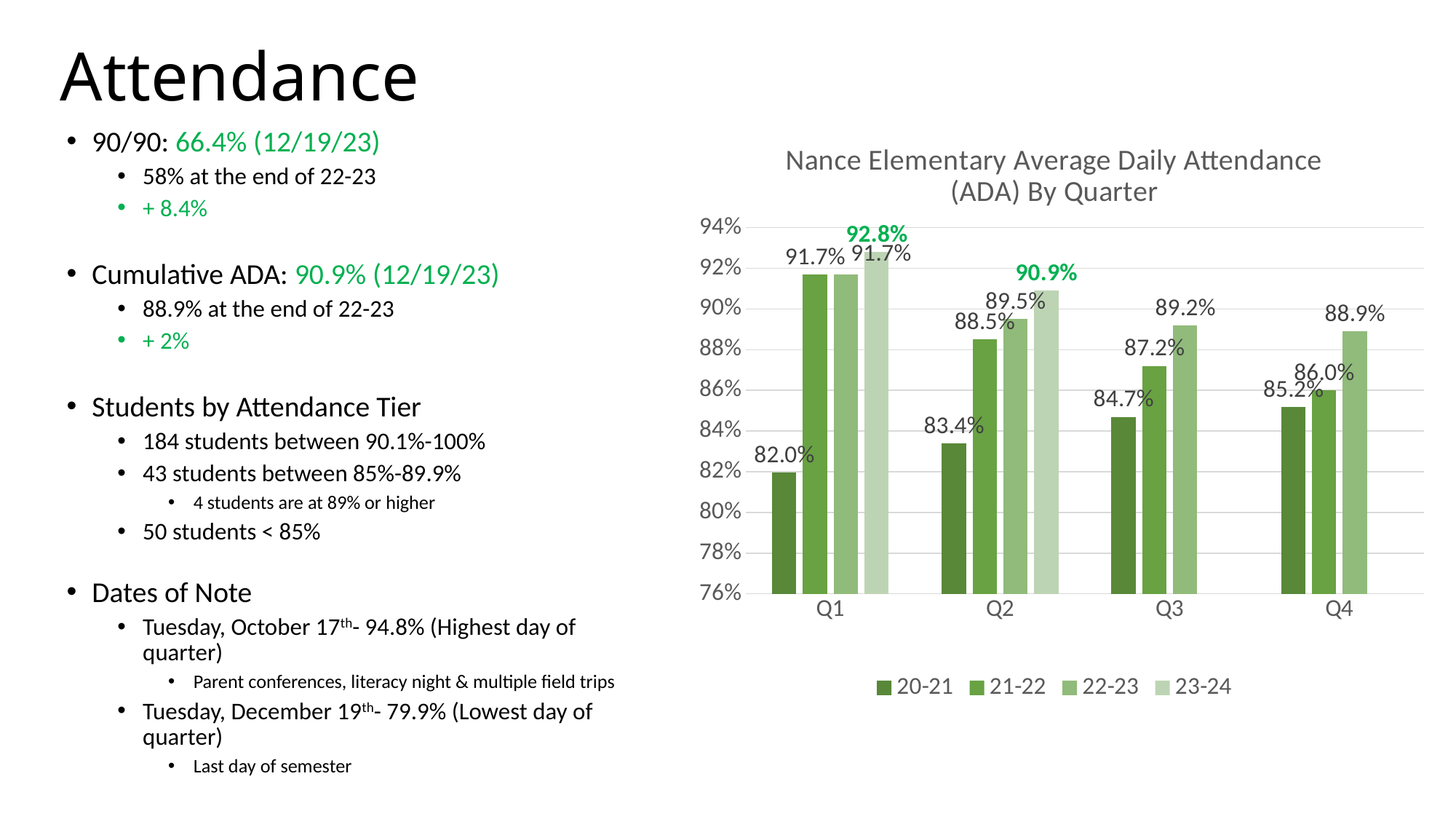
What is the 22-23 value for Q4? 88.9% What is the 20-21 value for Q2? 83.4% Do the 20-21 values rise or fall from Q1 to Q4? rise How many quarters are shown on the x axis of the chart? 4 What is the title of the chart? Nance Elementary Average Daily Attendance (ADA) By Quarter Which is larger in Q3: the 21-22 value or the 22-23 value? 22-23 Which quarter has the lowest 20-21 value? Q1 What is the 23-24 value for Q1? 92.8% Which series has the highest value in Q2? 23-24 How many series does the chart legend list? 4 What is the difference between the 23-24 and 20-21 values for Q1? 10.8% What type of chart is shown on the slide? bar chart